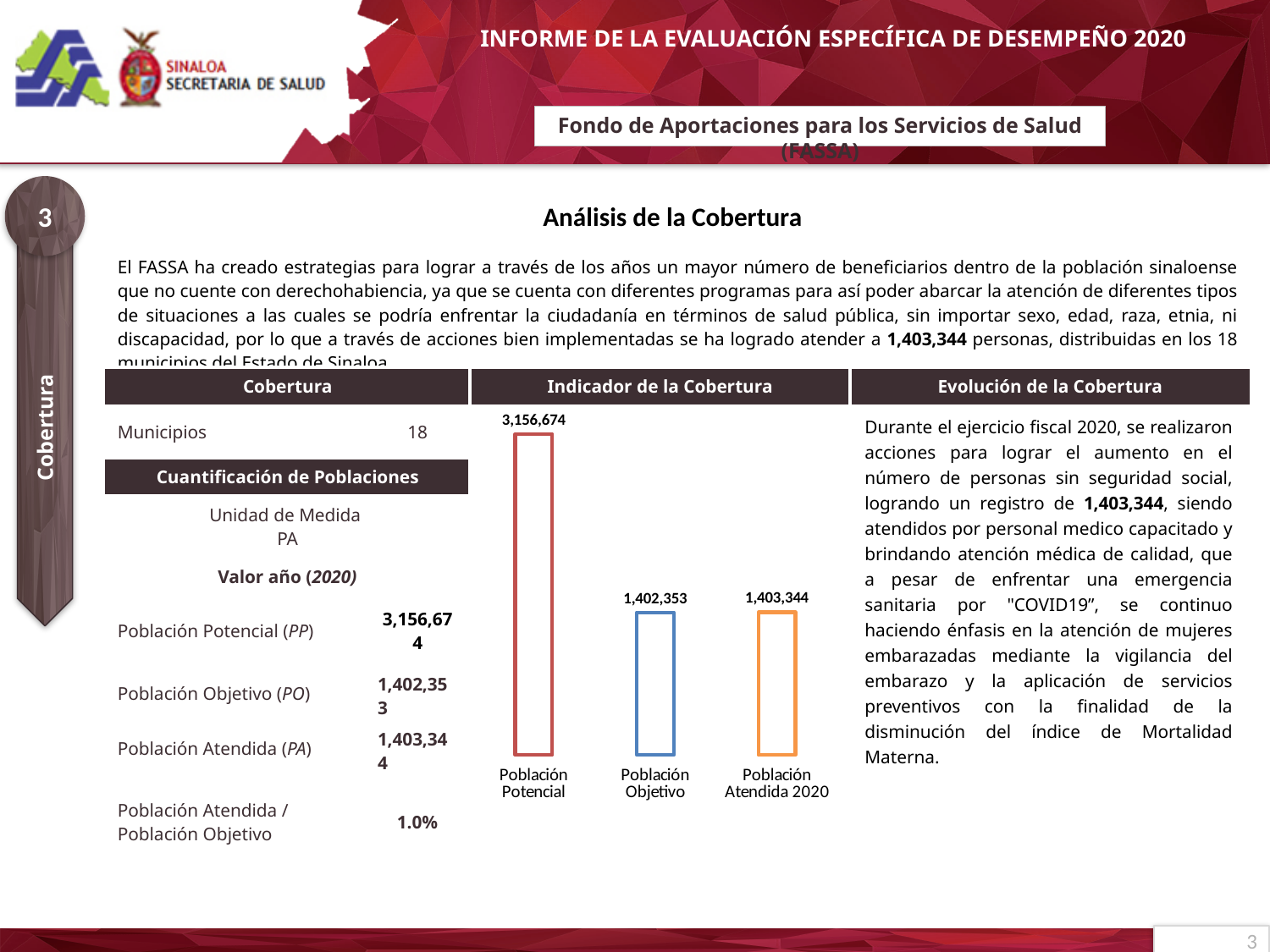
Which category has the lowest value in the chart? Población Objetivo Which category has the highest value in the chart? Población Potencial What type of chart is shown under "Indicador de la Cobertura"? Bar chart What is the value of the Población Potencial bar in the chart? 3,156,674 How many bars does the "Indicador de la Cobertura" chart have? 3 What is the difference between the Población Potencial and Población Atendida 2020 values in the chart? 1,753,330 What is the difference between the Población Potencial and Población Objetivo values in the chart? 1,754,321 Which is larger in the chart, Población Potencial or Población Atendida 2020? Población Potencial What is the difference between the Población Atendida 2020 and Población Objetivo values in the chart? 991 What is the value of the Población Atendida 2020 bar in the chart? 1,403,344 What colour is the outline of the Población Atendida 2020 bar in the chart? Orange What is the value of the Población Objetivo bar in the chart? 1,402,353